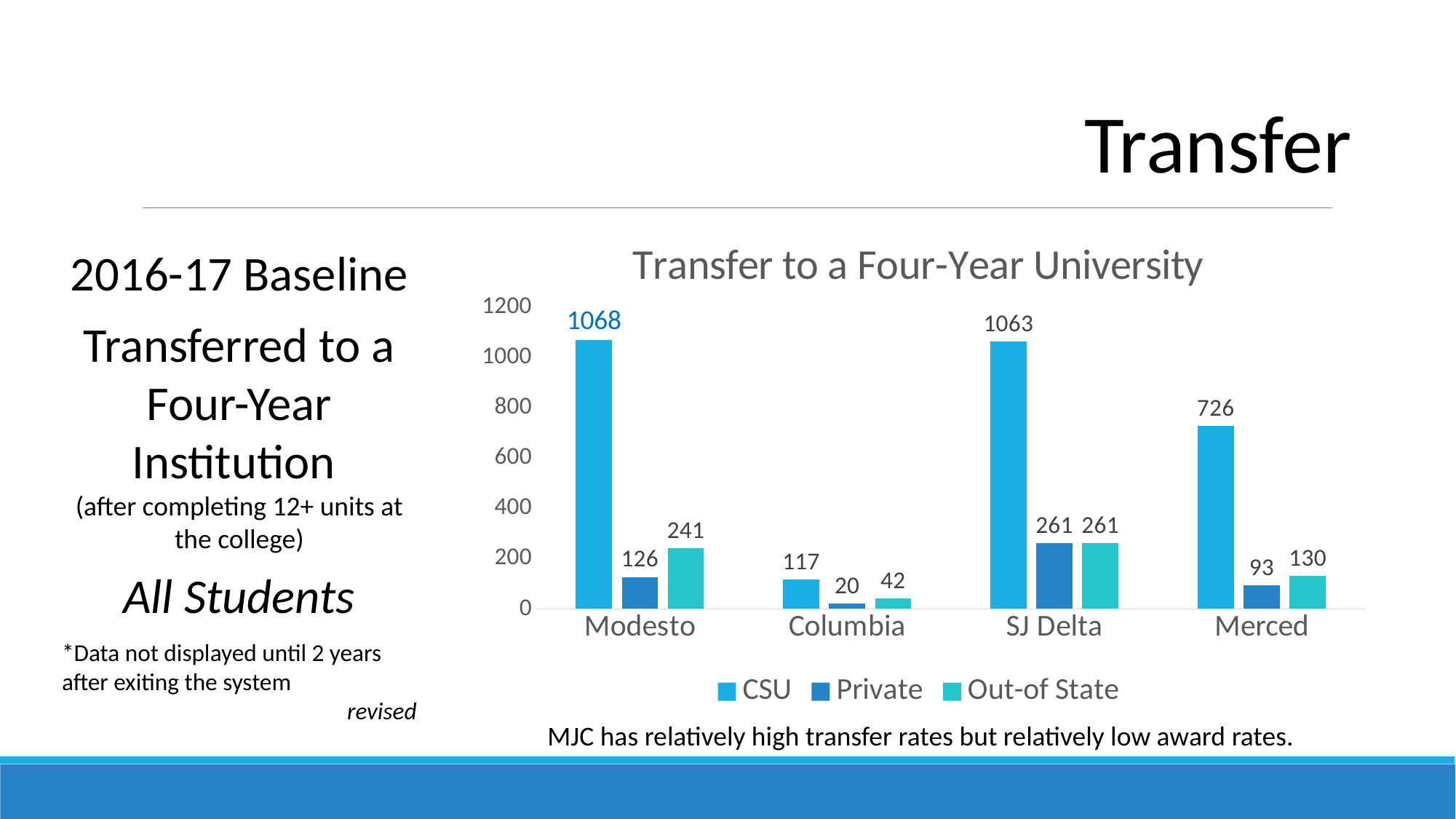
Which is larger, the Out-of State value for Modesto or the Out-of State value for Merced? Modesto What is the Out-of State value for Merced? 130 How many series does the legend list? 3 What is the difference between the CSU values for Modesto and Merced? 342 What is the CSU value for Modesto? 1068 What kind of chart is shown? bar chart Which college has the lowest CSU value? Columbia Which college has the highest Private value? SJ Delta What is the title of the chart? Transfer to a Four-Year University How many colleges are shown on the x axis? 4 What is the Private value for Columbia? 20 Is the CSU value for Merced greater or less than 600? greater